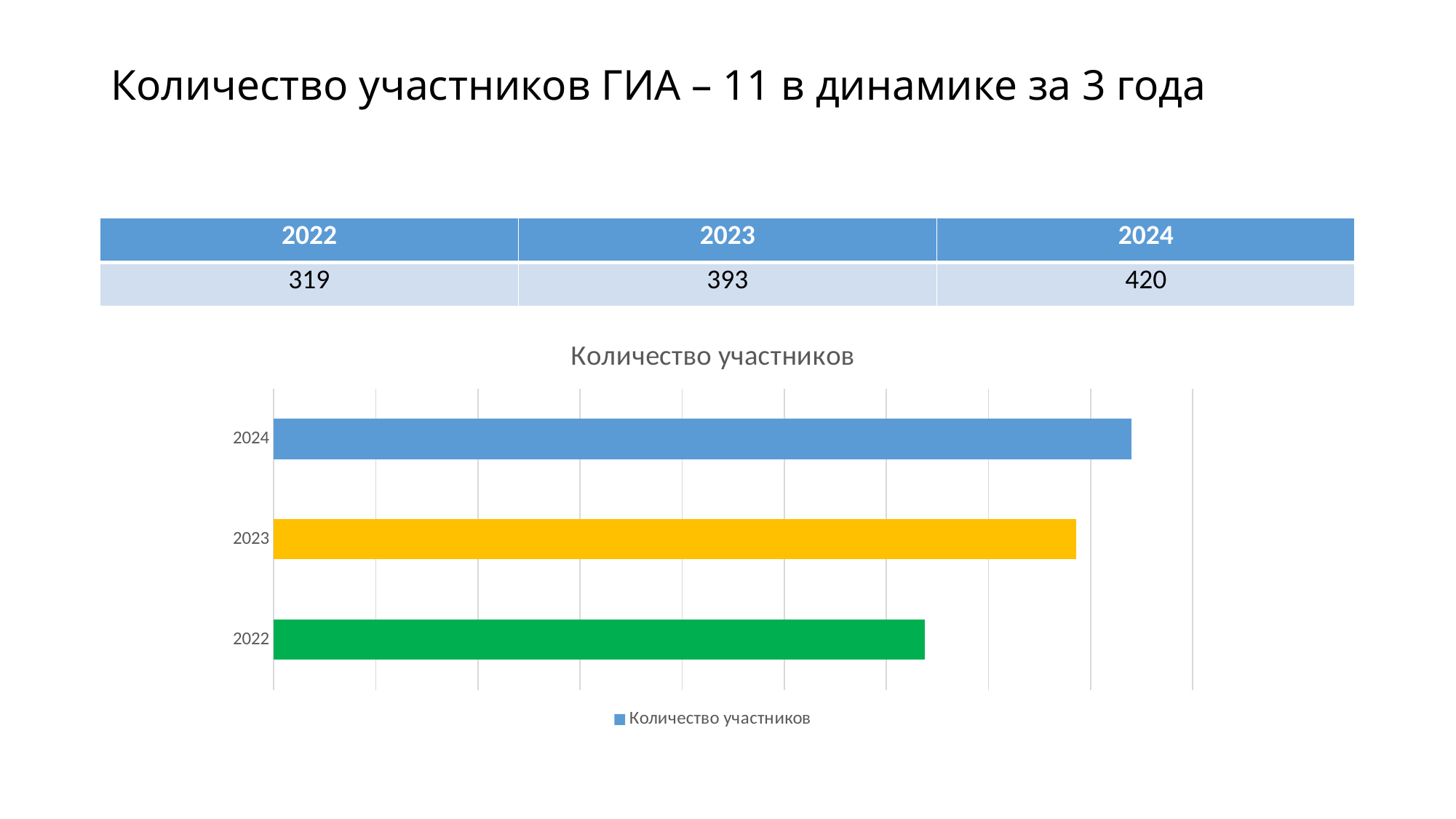
What is the title of the chart? Количество участников What is the difference between the number of participants in 2024 and in 2022? 101 What is the number of participants for 2022? 319 How many series does the chart legend list? 1 How many categories (years) does the chart show? 3 What kind of chart is shown on the slide? bar chart Which year has the lowest number of participants? 2022 What is the number of participants for 2023? 393 What is the number of participants for 2024? 420 Which year has the highest number of participants? 2024 Which year has more participants, 2023 or 2022? 2023 Do the number of participants rise or fall from 2022 to 2024? rise